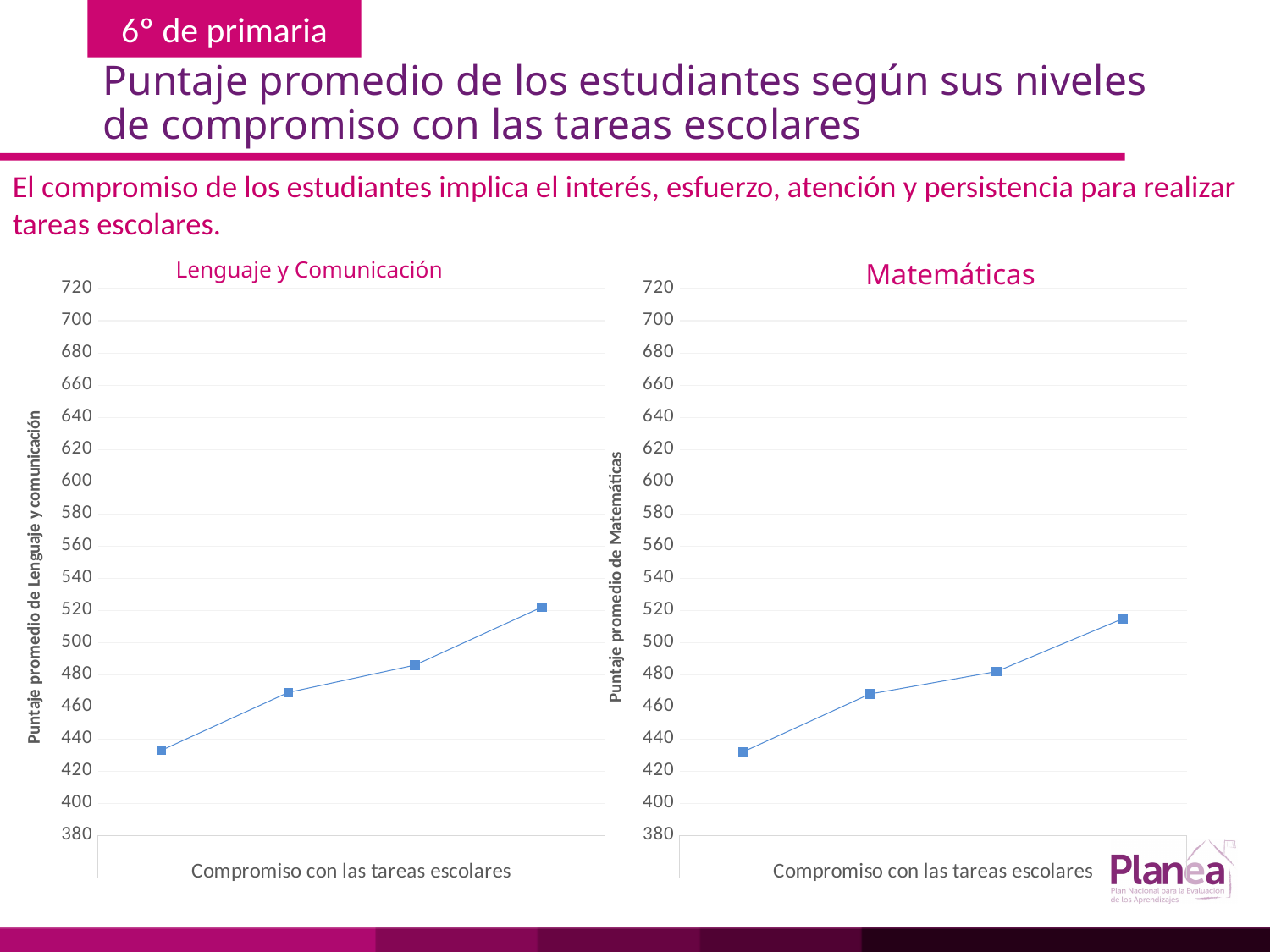
How many data points are plotted in the Matemáticas chart? 4 In the Matemáticas chart, is the value of the first (leftmost) point greater or less than 460? less What kind of chart is the Lenguaje y Comunicación chart? line chart In the Matemáticas chart, do the values rise or fall from left to right along the x axis? rise What is the x-axis title of the Matemáticas chart? Compromiso con las tareas escolares How many data points are plotted in the Lenguaje y Comunicación chart? 4 What is the y-axis title of the Lenguaje y Comunicación chart? Puntaje promedio de Lenguaje y comunicación In the Lenguaje y Comunicación chart, do the values rise or fall from left to right along the x axis? rise In the Matemáticas chart, is the value of the last (rightmost) point greater or less than 500? greater In the Lenguaje y Comunicación chart, is the value of the last (rightmost) point greater or less than 500? greater What kind of chart is the Matemáticas chart? line chart